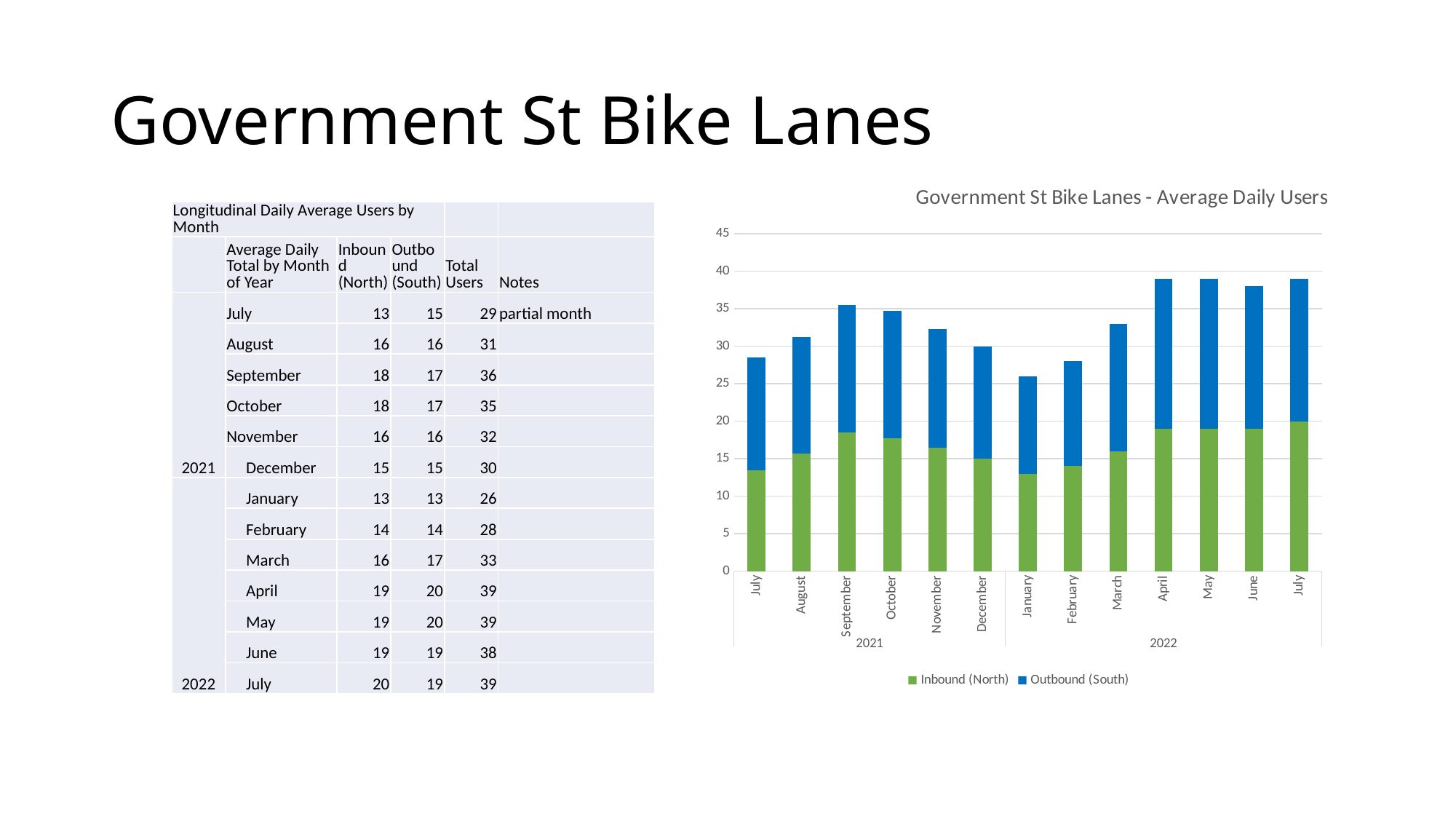
Which month has the lowest total bar in the chart? January 2022 Is the total bar for April 2022 greater or less than 35? greater How many monthly bars are plotted in the chart? 13 Which series is shown in green in the chart? Inbound (North) Which has the taller total bar, September 2021 or January 2022? September 2021 Which has the taller total bar, December 2021 or April 2022? April 2022 How many series does the chart legend list? 2 Is the total bar for January 2022 greater or less than 30? less Do the total bars rise or fall from January 2022 to April 2022? rise Is the Inbound (North) value for July 2022 greater or less than 15? greater What kind of chart is shown on the slide? Stacked bar chart What is the title of the chart? Government St Bike Lanes - Average Daily Users